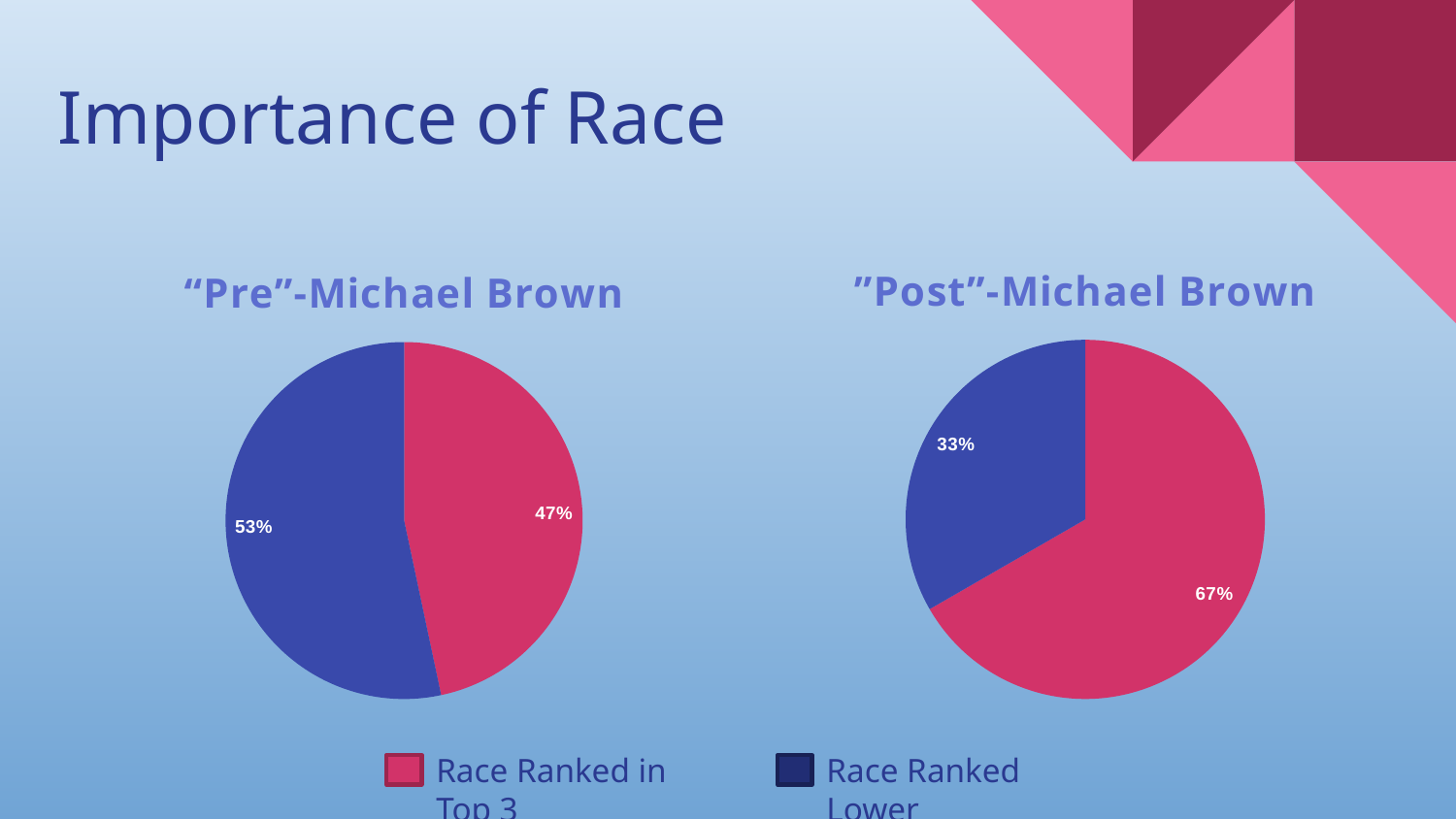
What colour represents Race Ranked Lower in the charts? Blue Which chart has the larger share for Race Ranked in Top 3, "Pre"-Michael Brown or "Post"-Michael Brown? "Post"-Michael Brown In the "Post"-Michael Brown chart, what share is labelled for Race Ranked Lower? 33% How many entries does the legend list? 2 What kind of charts are shown on the slide? Pie charts In the "Post"-Michael Brown chart, which slice is the largest? Race Ranked in Top 3 In the "Post"-Michael Brown chart, what share is labelled for Race Ranked in Top 3? 67% In the "Post"-Michael Brown chart, what is the difference between the Race Ranked in Top 3 share and the Race Ranked Lower share? 34% In the "Pre"-Michael Brown chart, what share is labelled for Race Ranked in Top 3? 47% In the "Pre"-Michael Brown chart, which slice is the smallest? Race Ranked in Top 3 How many slices does the "Pre"-Michael Brown pie chart have? 2 In the "Pre"-Michael Brown chart, what share is labelled for Race Ranked Lower? 53%